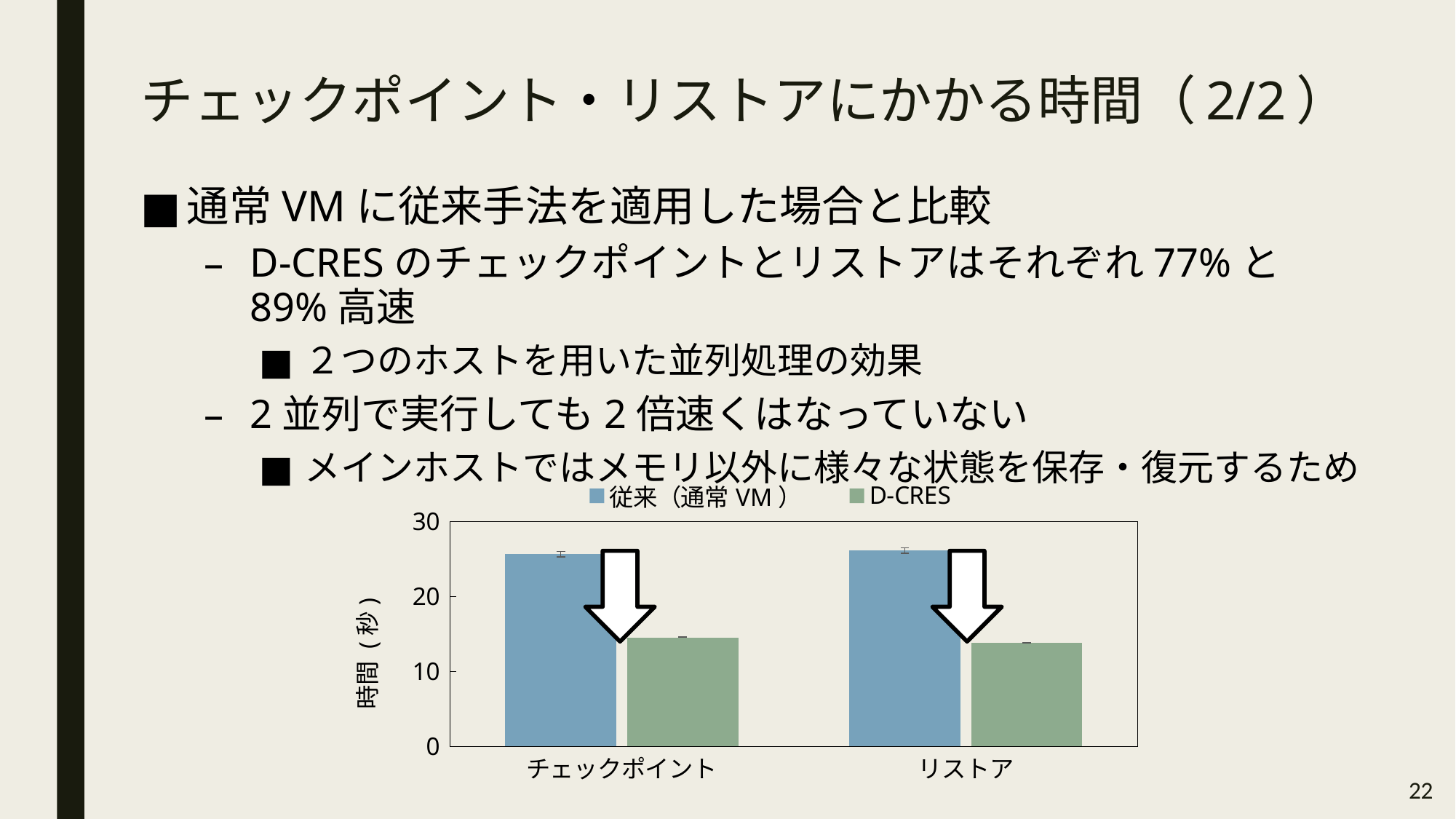
Is the value for D-CRES in the チェックポイント category greater or less than 10? greater In the チェックポイント category, which series has the larger value, 従来（通常 VM） or D-CRES? 従来（通常 VM） How many categories are shown on the x axis of the chart? 2 In the リストア category, which series has the smaller value, 従来（通常 VM） or D-CRES? D-CRES Is the value for 従来（通常 VM） in the リストア category greater or less than 20? greater Is the value for D-CRES in the リストア category greater or less than 20? less What are the two series listed in the chart's legend? 従来（通常 VM）, D-CRES How many series does the chart's legend list? 2 What kind of chart is shown on the slide? bar chart What is the label of the chart's y axis? 時間（秒）